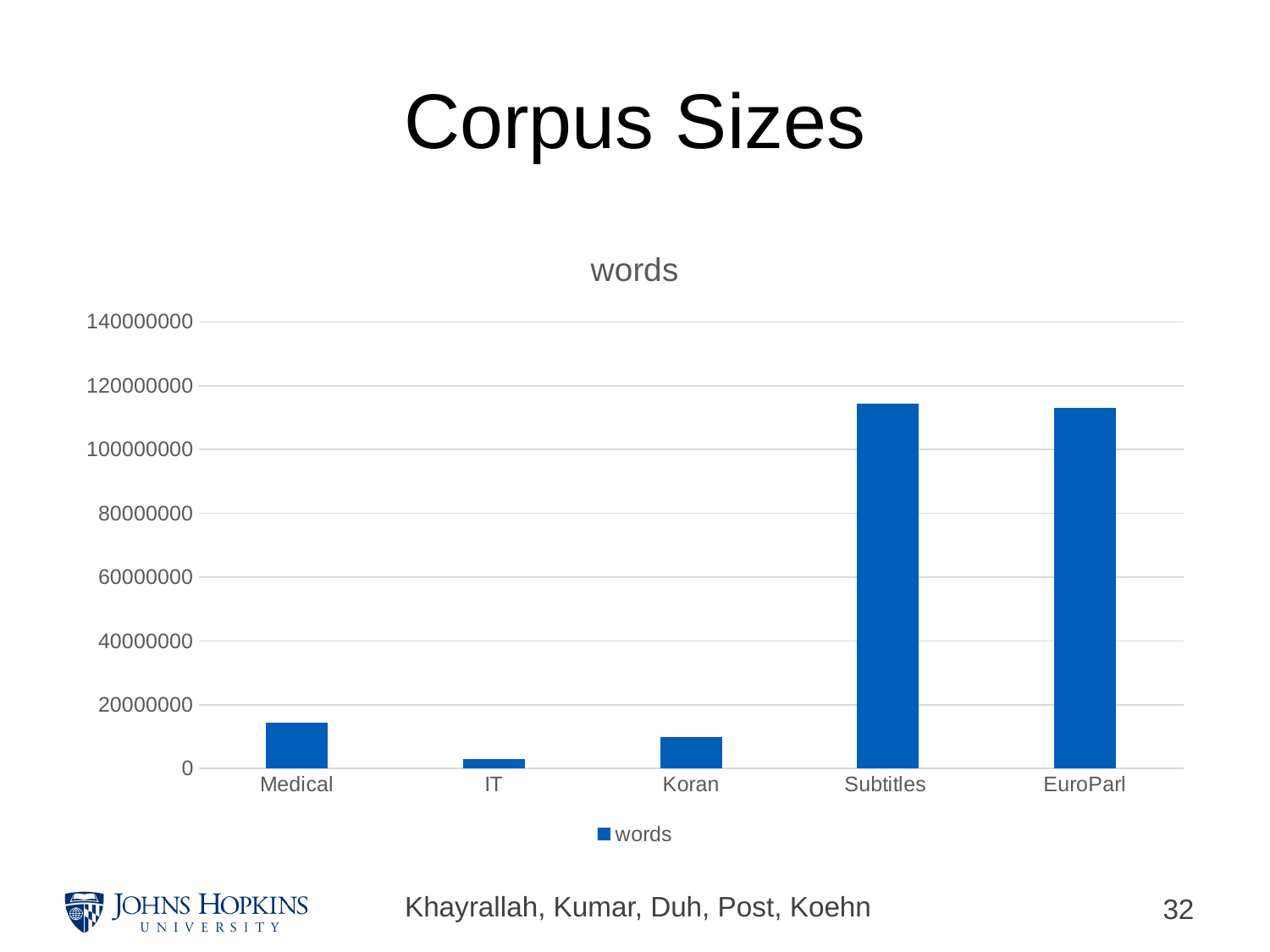
Is the value for Koran greater or less than 20000000? less Is the value for EuroParl greater or less than 120000000? less Which has a larger value, Medical or Koran? Medical Which has a larger value, Koran or Subtitles? Subtitles Which has a larger value, IT or Medical? Medical What is the title of the chart? words How many categories are shown on the x axis of the chart? 5 How many series does the chart's legend list? 1 What kind of chart is shown on the slide? bar chart Is the value for Medical greater or less than 20000000? less Which category has the lowest value in the chart? IT